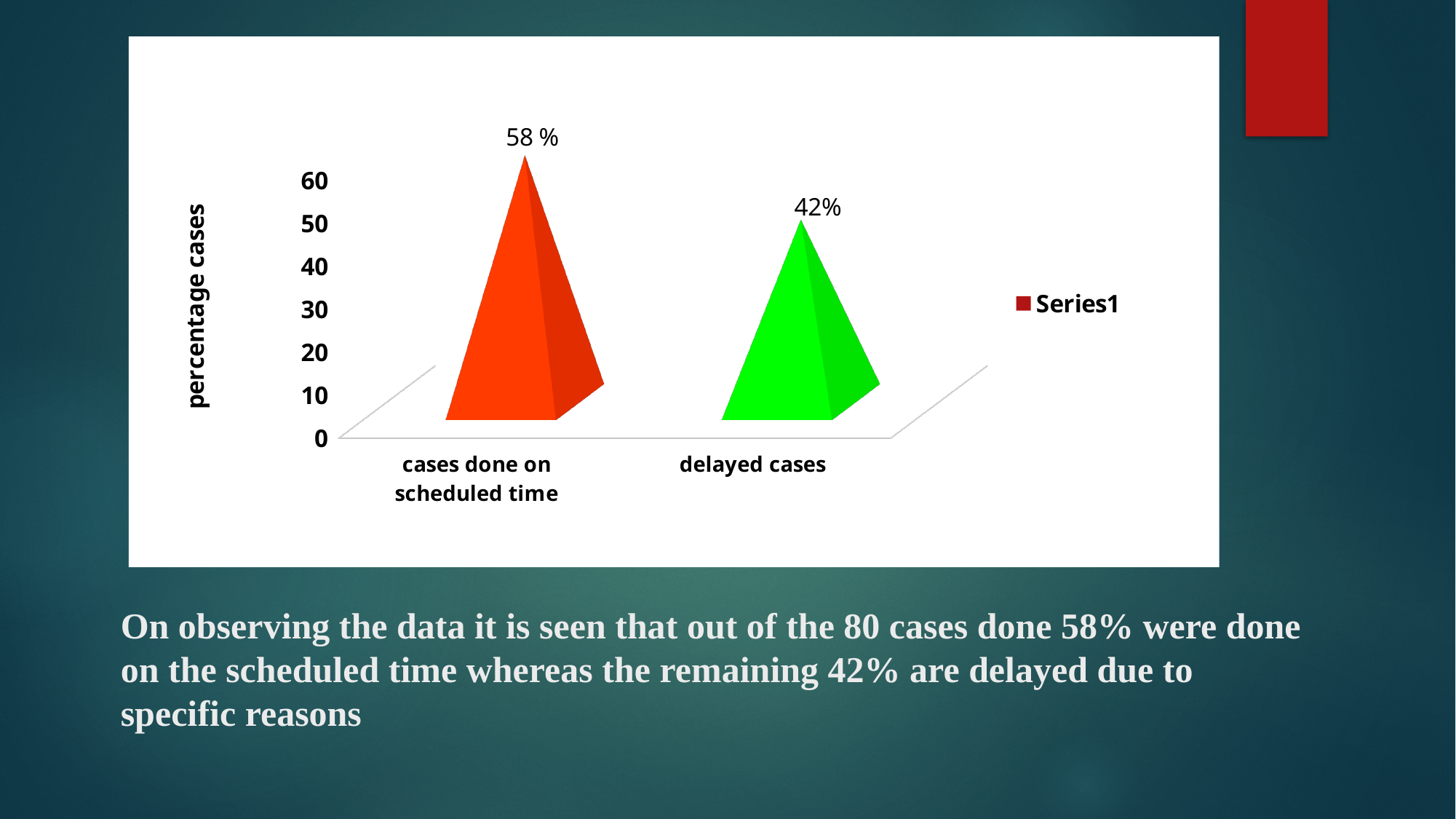
What is the difference between the value for cases done on scheduled time and the value for delayed cases? 16% Which is larger, the value for cases done on scheduled time or the value for delayed cases? cases done on scheduled time Is the value for cases done on scheduled time greater or less than 50? greater What kind of chart is shown on the slide? bar chart What is the value for cases done on scheduled time? 58 % What is the value for delayed cases? 42% How many series does the chart legend list? 1 Which category has the highest value? cases done on scheduled time What is the label of the vertical axis of the chart? percentage cases Is the value for delayed cases greater or less than 50? less How many categories are shown on the x axis of the chart? 2 Which category has the lowest value? delayed cases